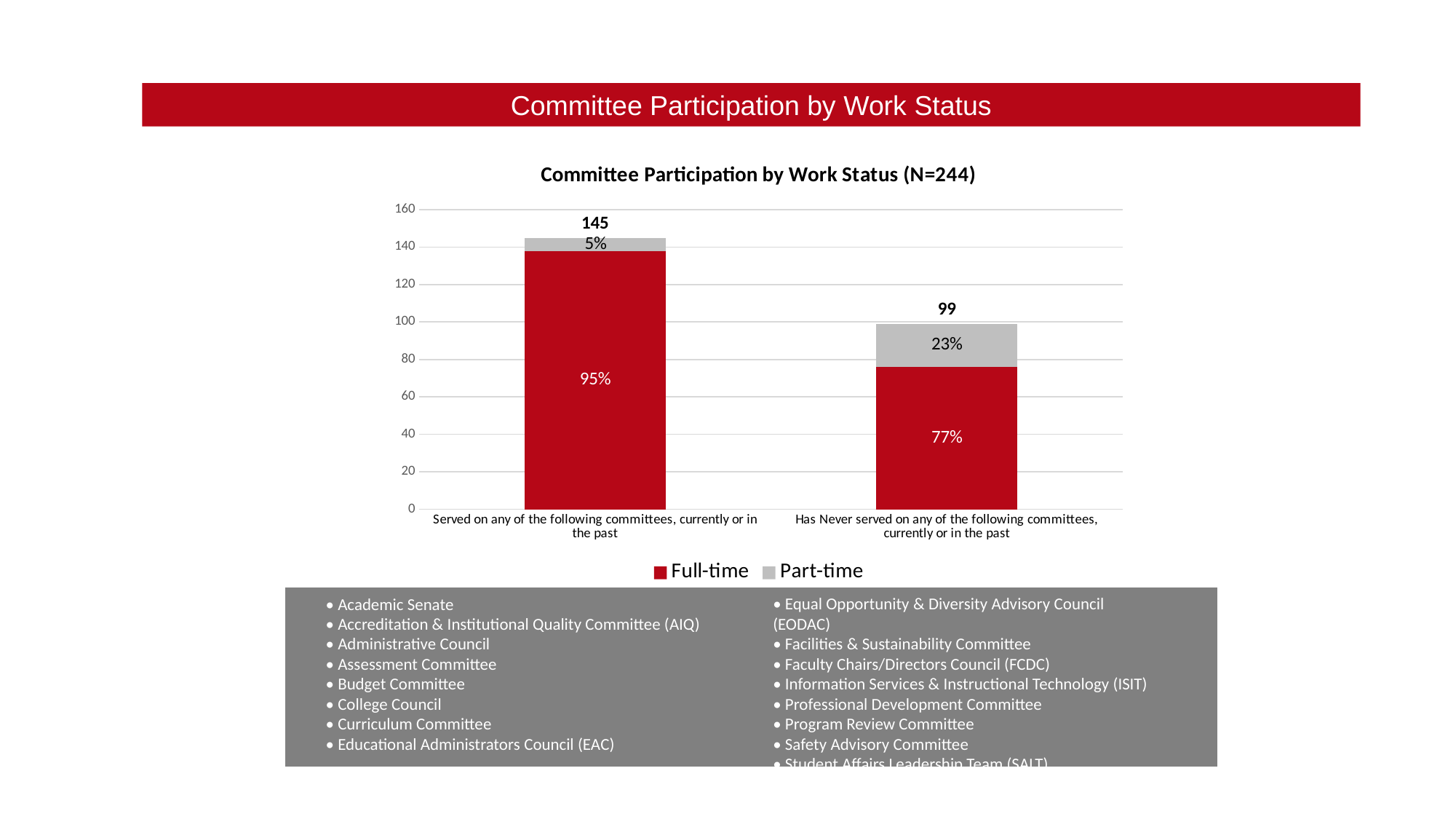
What is the total shown above the bar for 'Served on any of the following committees, currently or in the past'? 145 What percentage label is shown for the Full-time segment of the 'Served on any of the following committees' bar? 95% What is the difference between the two bar totals (145 and 99)? 46 What percentage label is shown for the Part-time segment of the 'Served on any of the following committees' bar? 5% How many series does the legend list? 2 What percentage label is shown for the Full-time segment of the 'Has Never served on any of the following committees' bar? 77% Is the total for 'Has Never served on any of the following committees' greater or less than 100? less What is the total shown above the bar for 'Has Never served on any of the following committees, currently or in the past'? 99 What kind of chart is shown on the slide? Stacked bar chart What percentage label is shown for the Part-time segment of the 'Has Never served on any of the following committees' bar? 23% What is the title of the chart? Committee Participation by Work Status (N=244) Which category has the higher total? Served on any of the following committees, currently or in the past